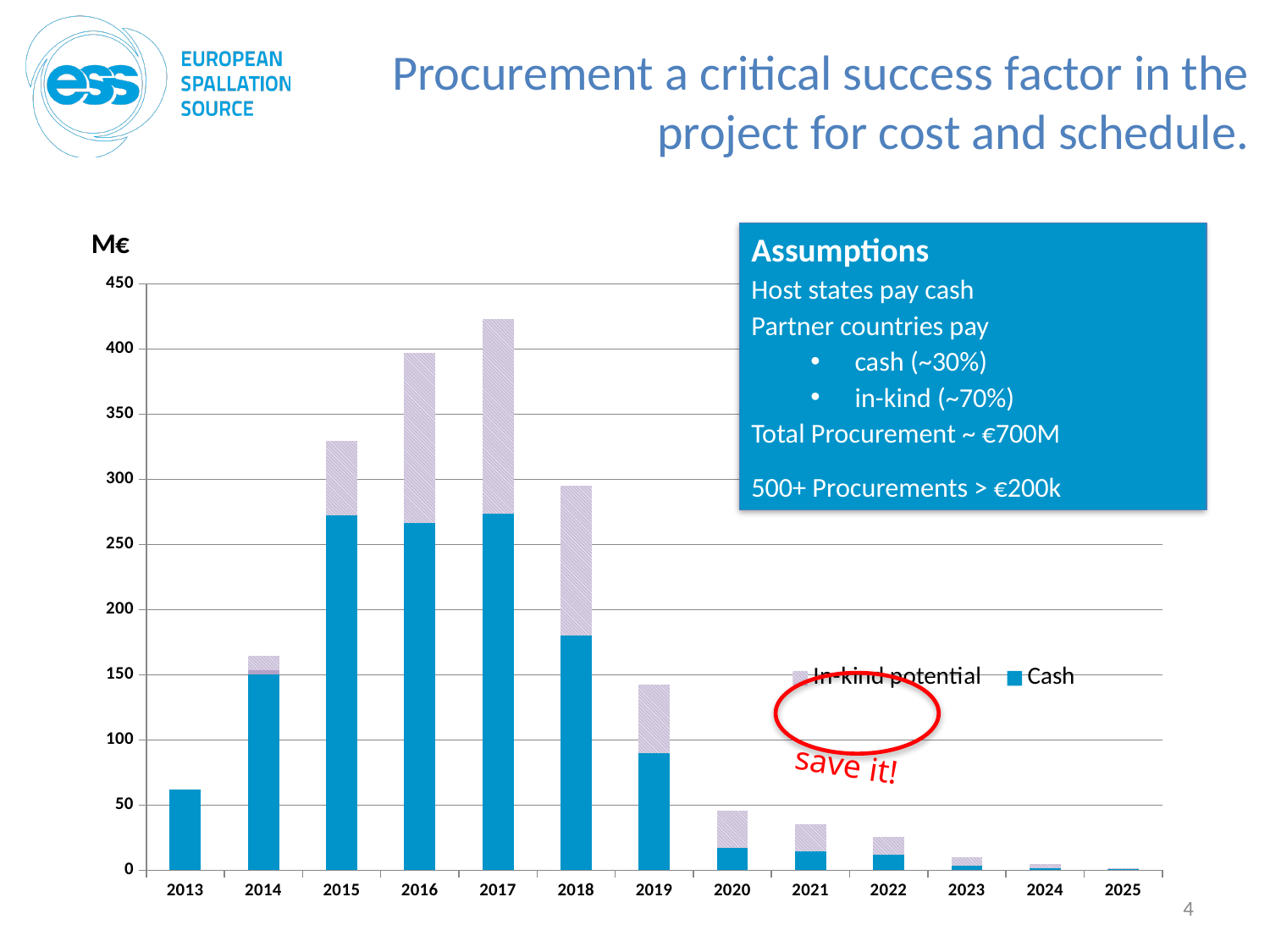
Is the total bar for 2017 greater or less than 400? greater How many years are shown on the x axis of the chart? 13 Which year has the lowest total bar in the chart? 2025 What unit label is shown above the y axis of the chart? M€ Is the total bar for 2019 greater or less than 150? less Which year has the highest total bar in the chart? 2017 Is the Cash value for 2018 greater or less than 150? greater What kind of chart is shown on the slide? Stacked bar chart Do the total bar values rise or fall from 2017 to 2025? fall Which year has the larger total bar, 2015 or 2016? 2016 How many series does the chart legend list? 2